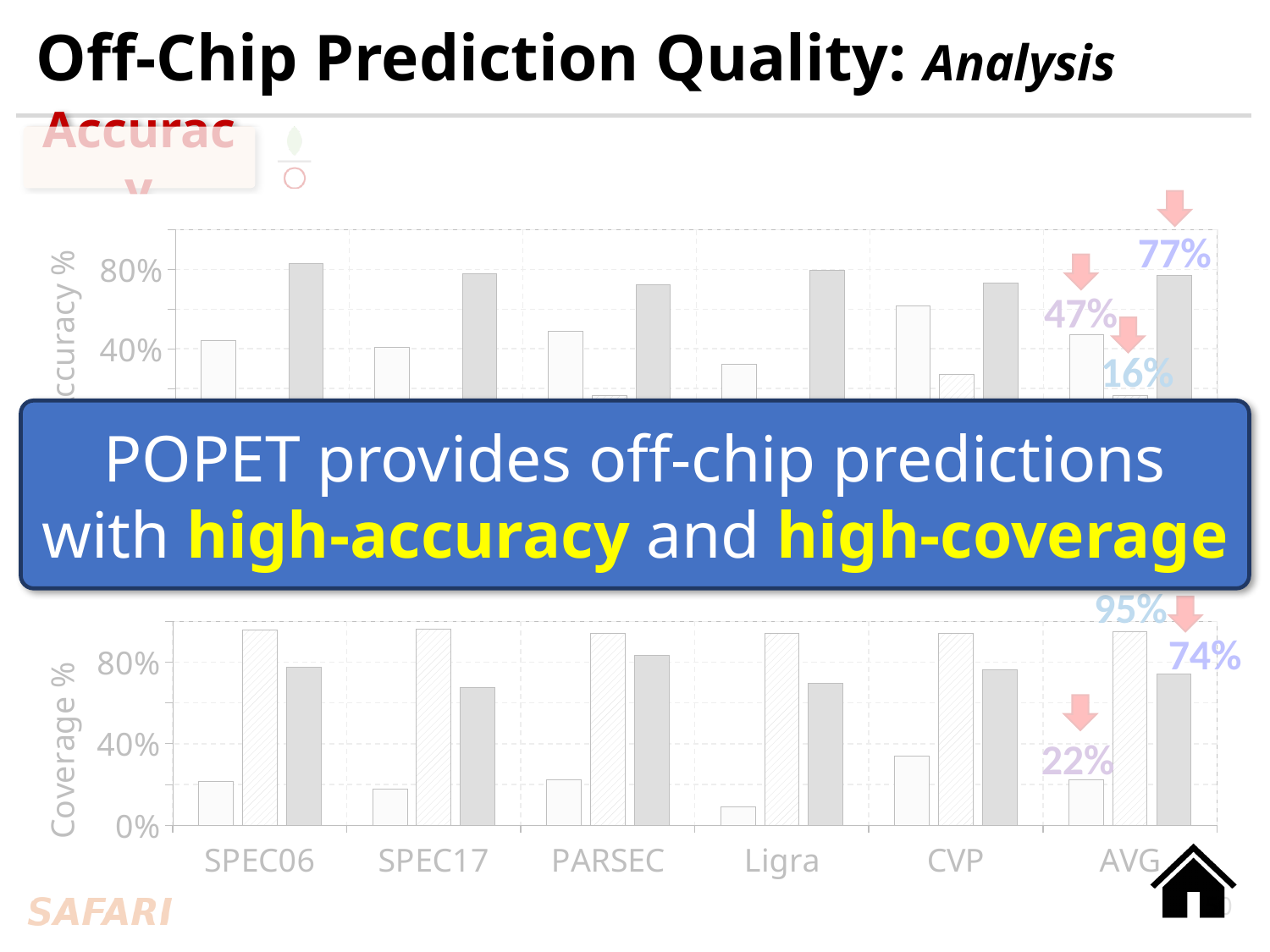
In the top Accuracy % chart, what is the labelled value of the first (white) bar for AVG? 47% In the top Accuracy % chart, what is the labelled value of the hatched (second) bar for AVG? 16% What kind of chart is the bottom chart labelled Coverage %? bar chart In the bottom Coverage % chart, what is the labelled value of the hatched (second) bar for AVG? 95% In the top Accuracy % chart for AVG, which is larger: the first bar (47%) or the grey bar (77%)? the grey bar (77%) How many categories are shown along the x axis of the Coverage % chart? 6 In the bottom Coverage % chart, what is the labelled value of the grey (third) bar for AVG? 74% In the top Accuracy % chart, what is the difference between the grey bar (77%) and the first bar (47%) for AVG? 30% In the bottom Coverage % chart, which category has the lowest first (white) bar? Ligra In the top Accuracy % chart, what is the labelled value of the grey (third) bar for AVG? 77% In the bottom Coverage % chart, is the value of the first (white) bar for SPEC06 greater or less than 40%? less In the bottom Coverage % chart, what is the difference between the hatched bar (95%) and the grey bar (74%) for AVG? 21%